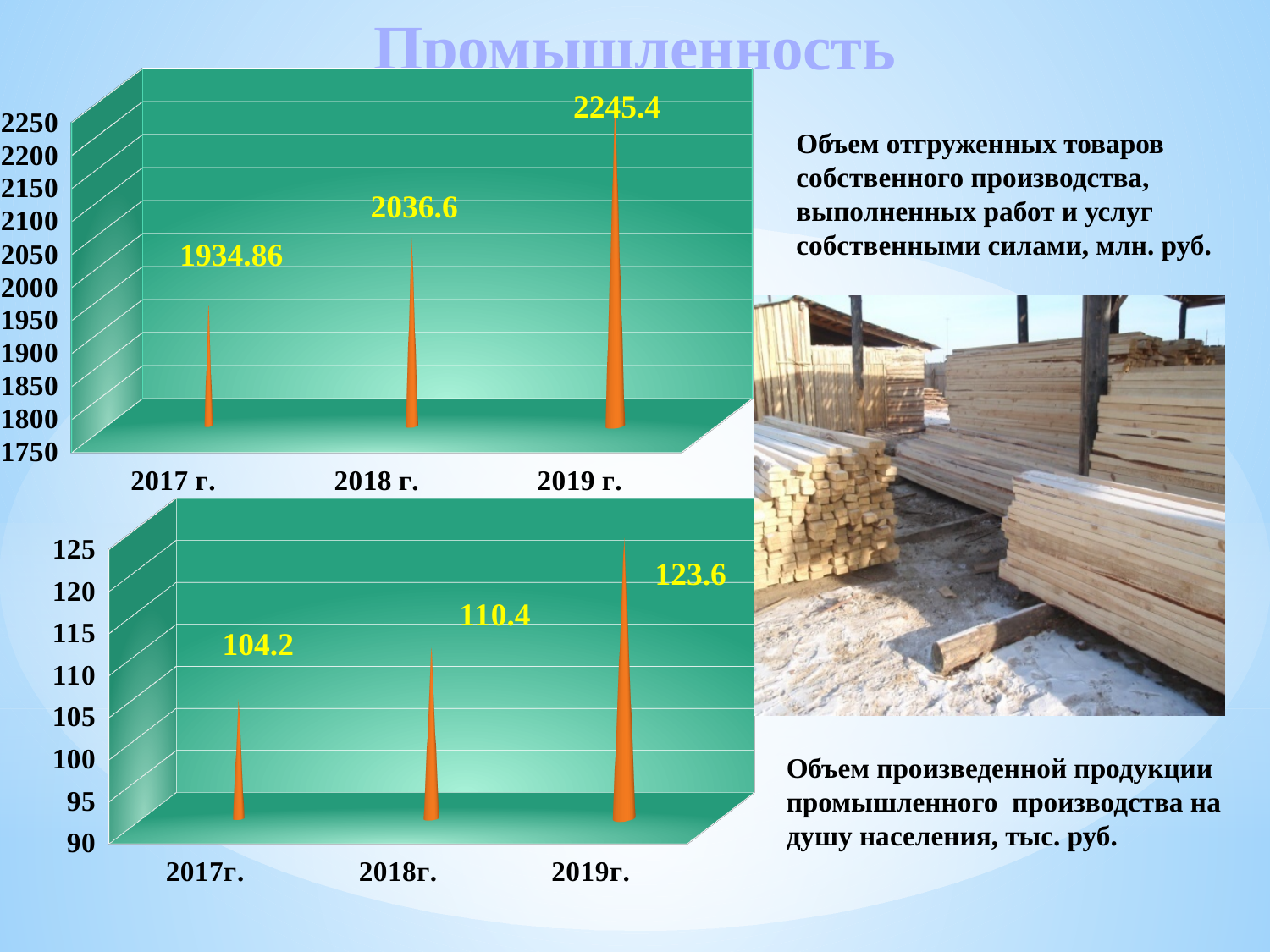
In the top chart, which is larger, the value for 2018 г. or the value for 2017 г.? 2018 г. In the bottom chart, what is the value for 2019г.? 123.6 What kind of chart is the top chart? bar chart How many years are shown in the bottom chart? 3 In the bottom chart, which year has the lowest value? 2017г. In the top chart, what is the difference between the values for 2019 г. and 2018 г.? 208.8 In the bottom chart, what is the value for 2018г.? 110.4 In the top chart, what is the value for 2017 г.? 1934.86 In the bottom chart, do the values rise or fall from 2017г. to 2019г.? rise In the bottom chart, what is the difference between the values for 2019г. and 2017г.? 19.4 In the top chart, which year has the highest value? 2019 г. In the top chart, what is the value for 2019 г.? 2245.4